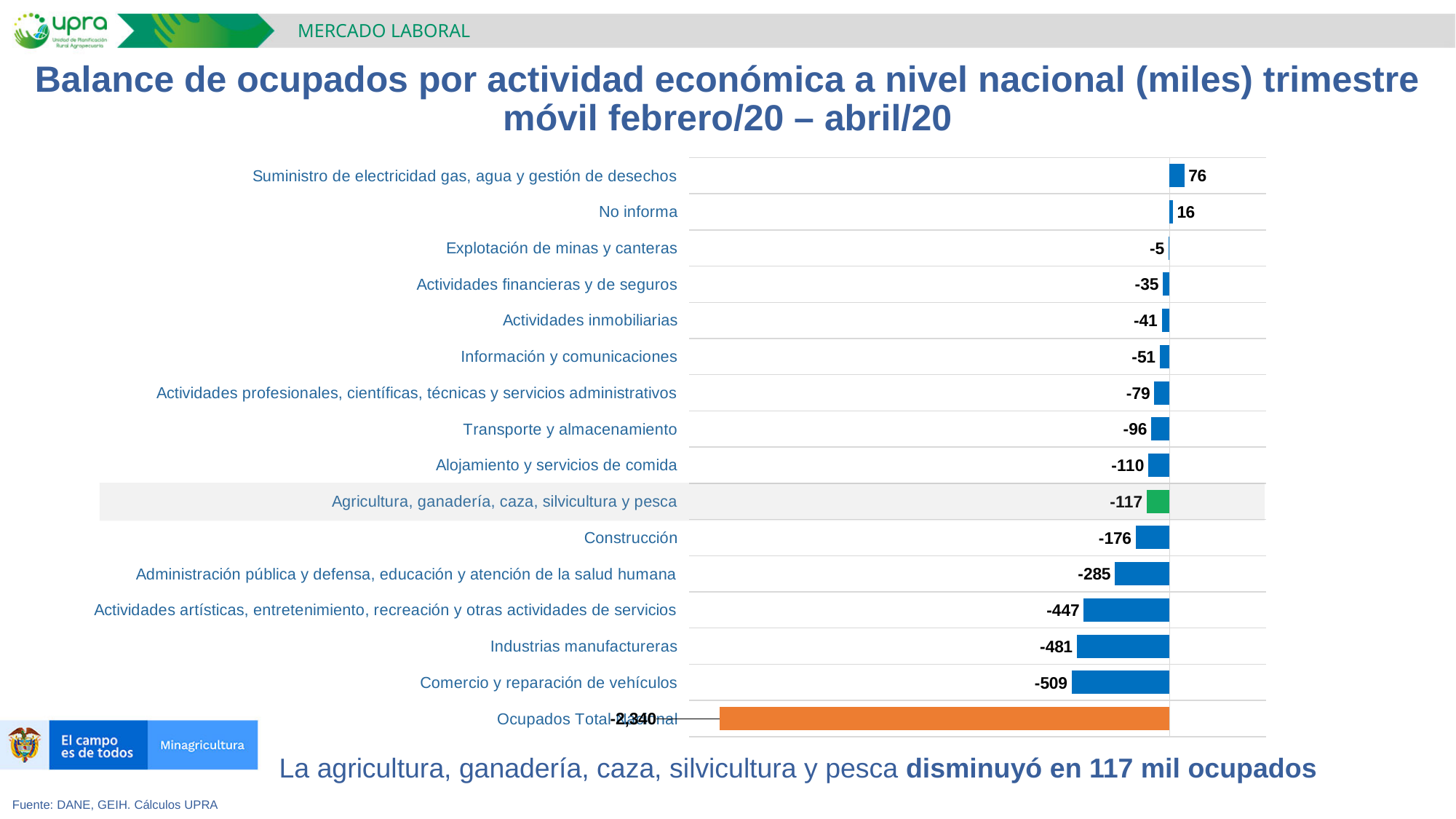
What is the value for Agricultura, ganadería, caza, silvicultura y pesca? -117 What is the value for Suministro de electricidad gas, agua y gestión de desechos? 76 What is the value for Comercio y reparación de vehículos? -509 Which category has the highest value? Suministro de electricidad gas, agua y gestión de desechos What is the difference between the values for Construcción and Agricultura, ganadería, caza, silvicultura y pesca? 59 What is the value for Administración pública y defensa, educación y atención de la salud humana? -285 What is the value for Industrias manufactureras? -481 What kind of chart is shown on the slide? bar chart How many categories are shown in the chart? 16 Which category's bar is coloured green? Agricultura, ganadería, caza, silvicultura y pesca Which is larger, the value for Transporte y almacenamiento or the value for Alojamiento y servicios de comida? Transporte y almacenamiento Which category has the lowest value? Ocupados Total Nacional